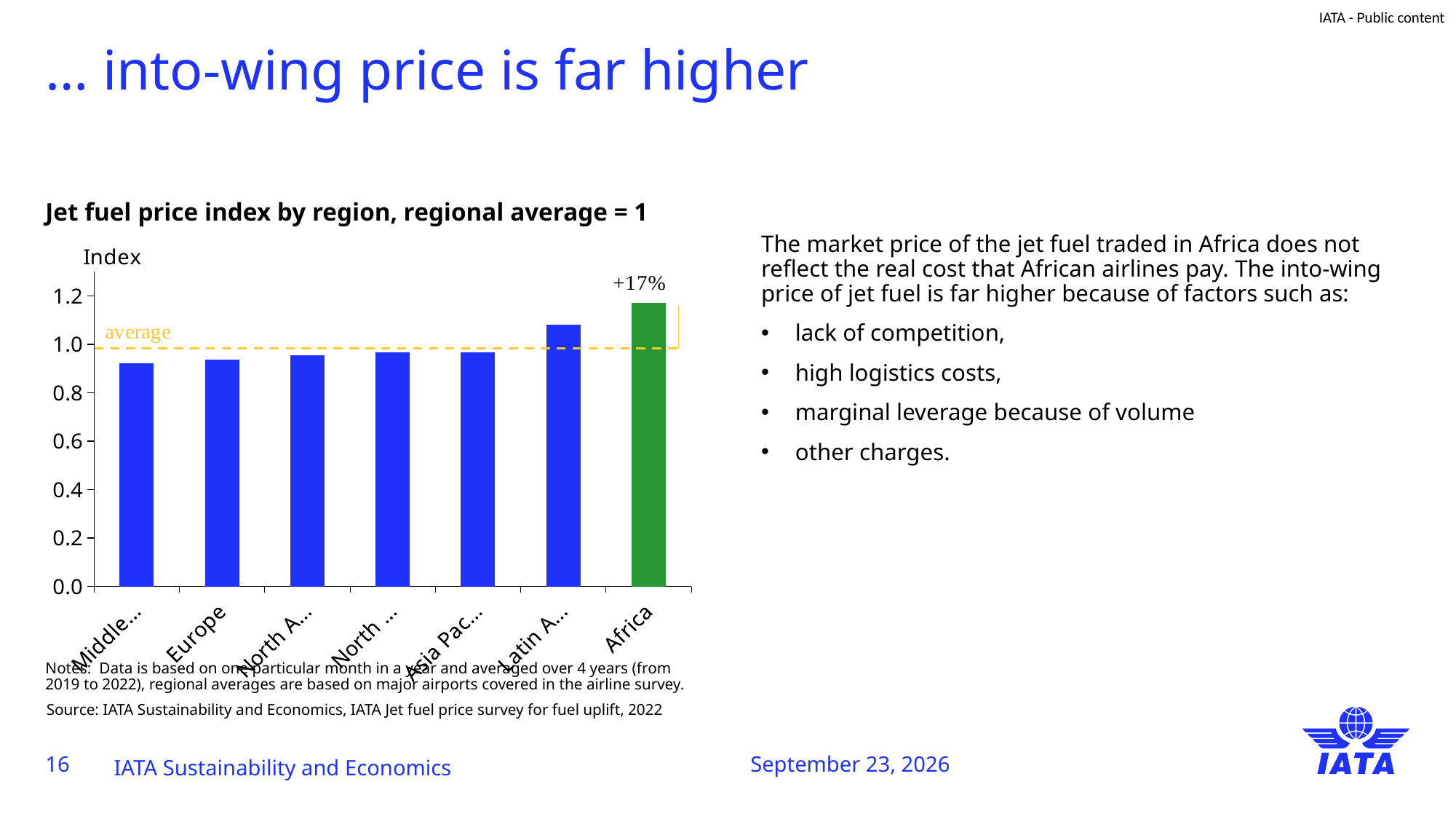
What label is printed above the Africa bar? +17% What is the title of the chart? Jet fuel price index by region, regional average = 1 How many regions (bars) are plotted in the chart? 7 What colour is the Africa bar? green Which region has the highest jet fuel price index? Africa Is the jet fuel price index for Africa greater or less than 1.0? greater Which has a higher jet fuel price index, Africa or Europe? Africa Do the bar values generally rise or fall from left to right across the regions? rise Is the jet fuel price index for Europe greater or less than 0.8? greater What kind of chart is shown on the slide? bar chart Is the jet fuel price index for Europe greater or less than 1.0? less